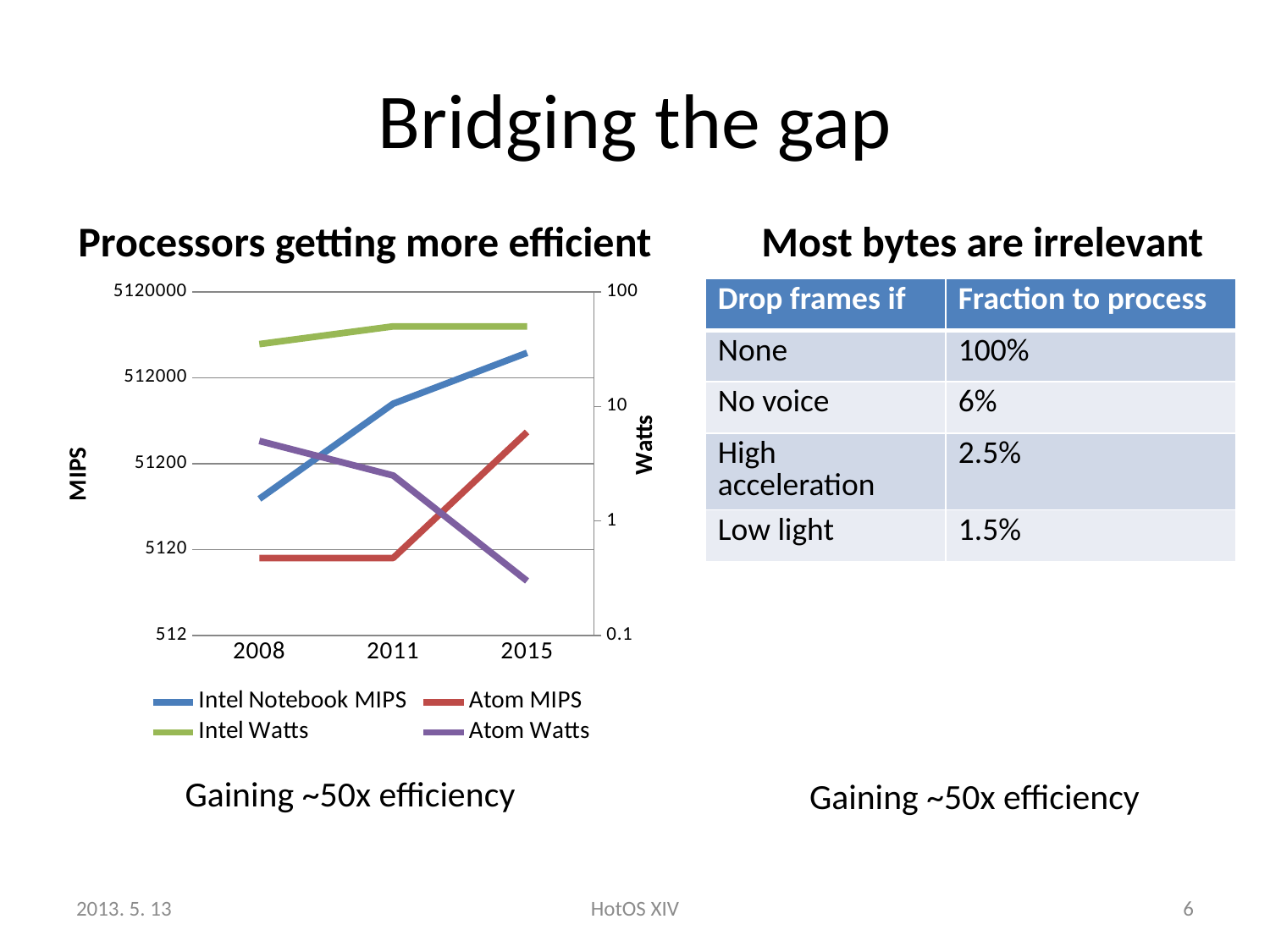
Is the value for Intel Notebook MIPS in 2008 greater or less than 5120? greater What is the title of the chart? Processors getting more efficient Is the value for Atom MIPS in 2015 greater or less than 51200? greater Does the Intel Notebook MIPS series rise or fall from 2008 to 2015? rise Does the Atom Watts series rise or fall from 2008 to 2015? fall Is the value for Atom Watts in 2015 greater or less than 1? less How many series does the legend of the chart list? 4 What is the label of the right-hand vertical axis of the chart? Watts What kind of chart is shown on the slide? line chart How many years are shown on the x axis of the chart? 3 In 2011, which is larger: Intel Notebook MIPS or Atom MIPS? Intel Notebook MIPS